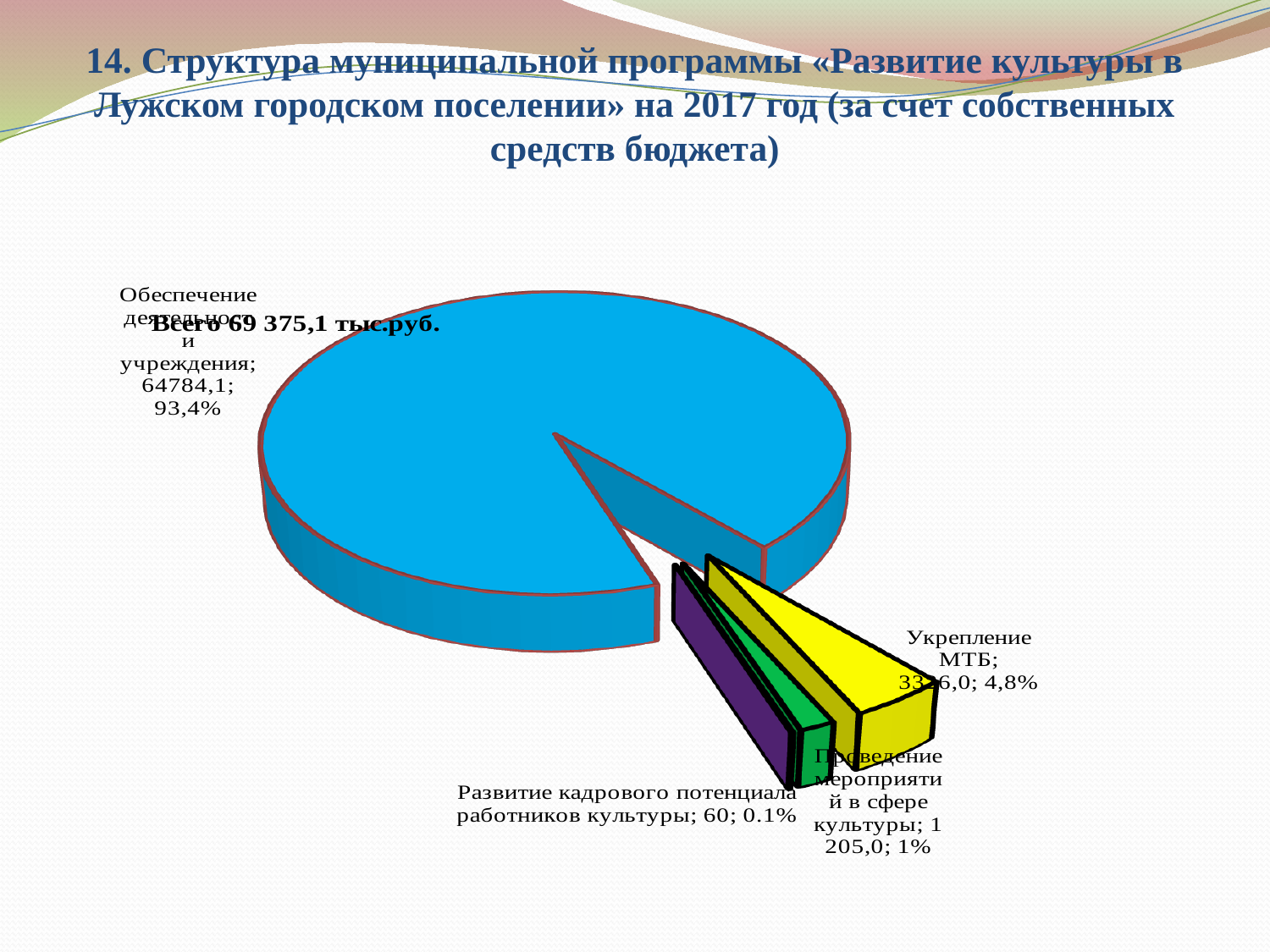
What share of the pie does «Обеспечение деятельности учреждения» represent? 93,4% What total amount is stated on the chart (Всего)? 69 375,1 тыс.руб. Which is larger: the share for «Укрепление МТБ» or the share for «Проведение мероприятий в сфере культуры»? Укрепление МТБ How many slices does the pie chart have? 4 What kind of chart is shown on the slide? pie chart Which category has the largest share of the pie? Обеспечение деятельности учреждения What is the value shown for «Обеспечение деятельности учреждения»? 64784,1 Which category has the smallest share of the pie? Развитие кадрового потенциала работников культуры What is the value shown for «Развитие кадрового потенциала работников культуры»? 60 What is the value shown for «Проведение мероприятий в сфере культуры»? 1 205,0 What share of the pie does «Проведение мероприятий в сфере культуры» represent? 1% What share of the pie does «Укрепление МТБ» represent? 4,8%